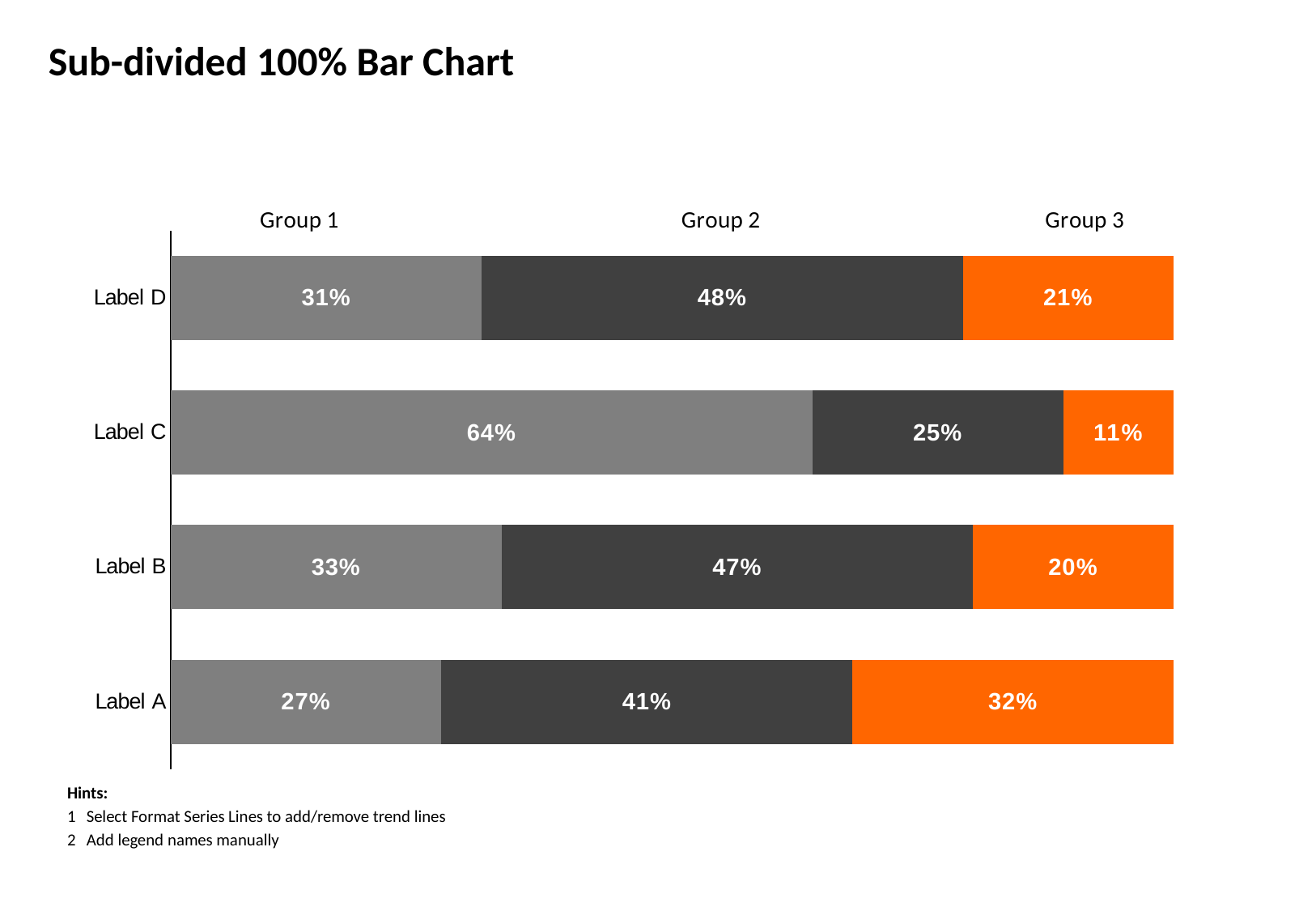
What kind of chart is shown on the slide? Stacked bar chart How many labels (categories) are shown on the chart? 4 Which label has the highest Group 1 value? Label C What is the Group 3 value for Label A? 32% What is the Group 1 value for Label C? 64% Which is larger, the Group 3 value for Label A or the Group 3 value for Label D? Label A Which label has the lowest Group 3 value? Label C What is the difference between the Group 2 values for Label D and Label C? 23% How many groups (series) does the chart show? 3 What is the Group 2 value for Label B? 47% What is the title of the slide? Sub-divided 100% Bar Chart What is the total of the three segments in the Label B bar? 100%